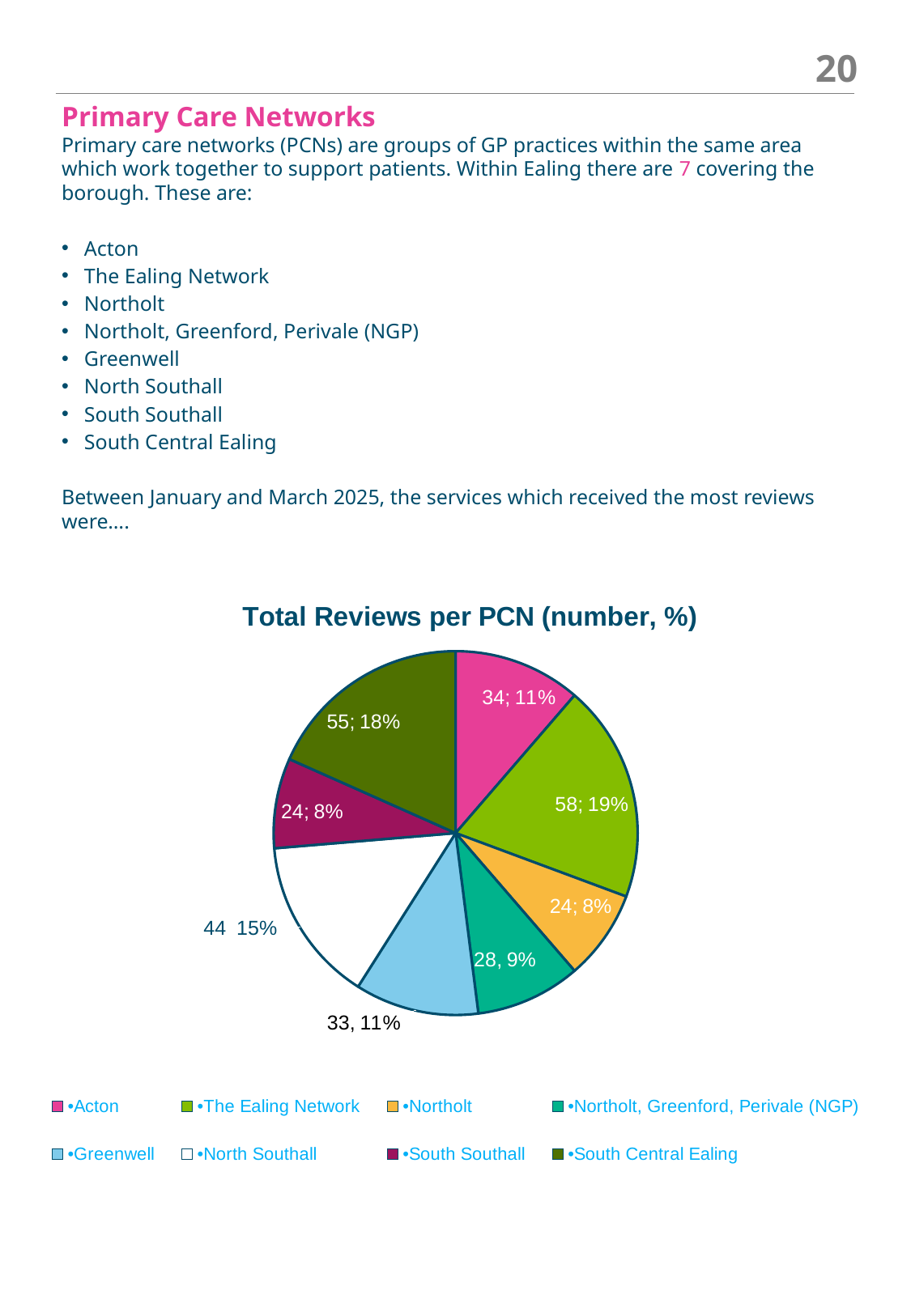
How many reviews did Acton receive? 34 Which received more reviews, North Southall or Greenwell? North Southall What percentage share of total reviews does South Central Ealing have? 18% How many reviews did Northolt, Greenford, Perivale (NGP) receive? 28 Which PCN received the most reviews? The Ealing Network What is the difference in number of reviews between The Ealing Network and South Central Ealing? 3 How many reviews did The Ealing Network receive according to the pie chart? 58 What is the percentage share for North Southall? 15% What is the title of the pie chart? Total Reviews per PCN (number, %) How many PCNs are listed in the chart legend? 8 What type of chart is shown on the slide? pie chart How many reviews did Greenwell receive? 33